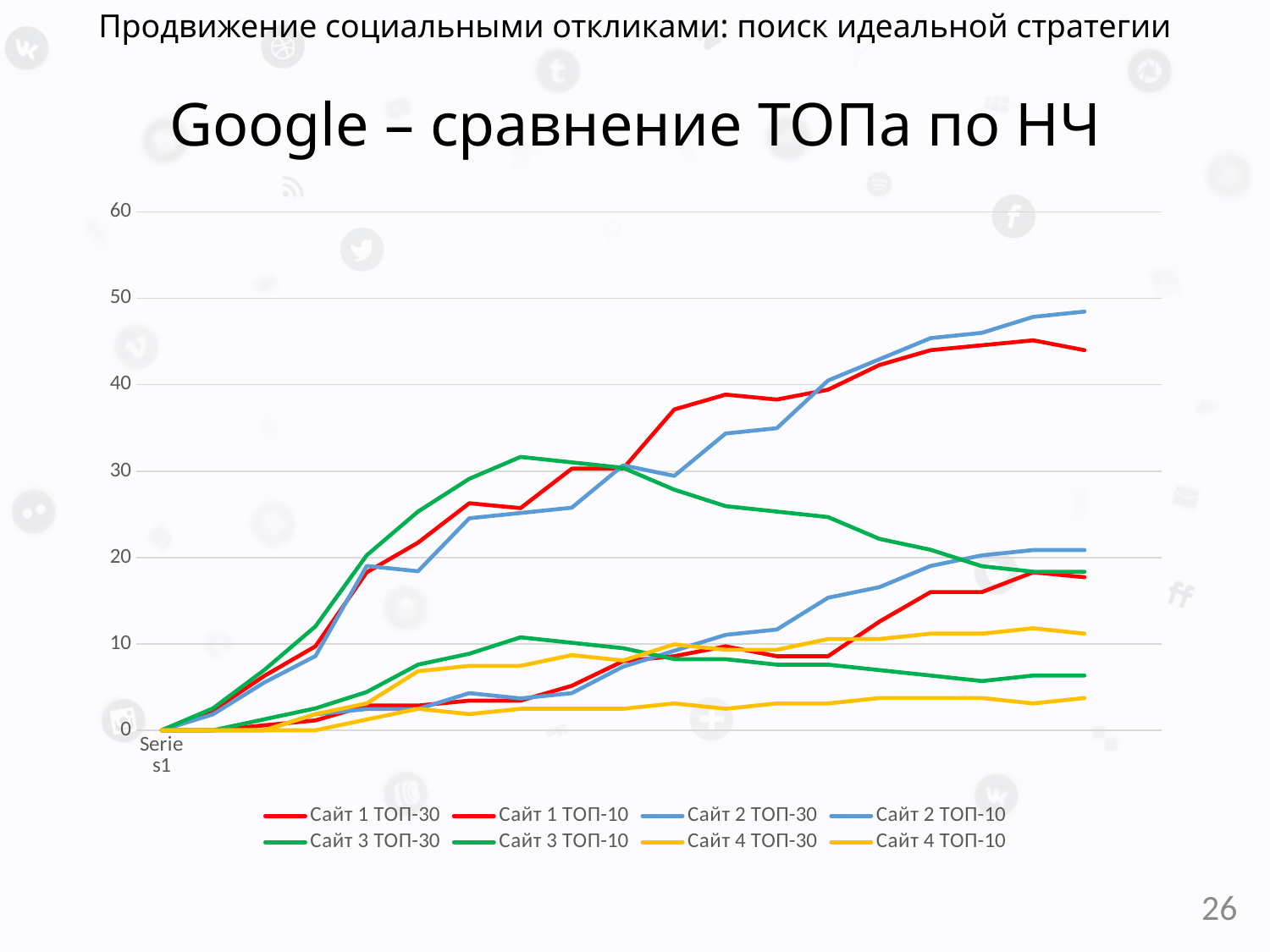
How many series does the legend list? 8 What is the title of the chart? Google – сравнение ТОПа по НЧ Does the upper blue line generally rise or fall from left to right? rise What kind of chart is shown on the slide? line chart What is the highest value shown on the vertical axis? 60 Is the final value of the upper green line greater or less than 20? less At the right end of the chart, which is larger: the upper blue line or the upper green line? the upper blue line Which colour line reaches the highest value at the right end of the chart? blue Is the final value of the upper red line greater or less than 40? greater Which colour line has the lowest value at the right end of the chart? yellow Is the final value of the upper blue line greater or less than 40? greater